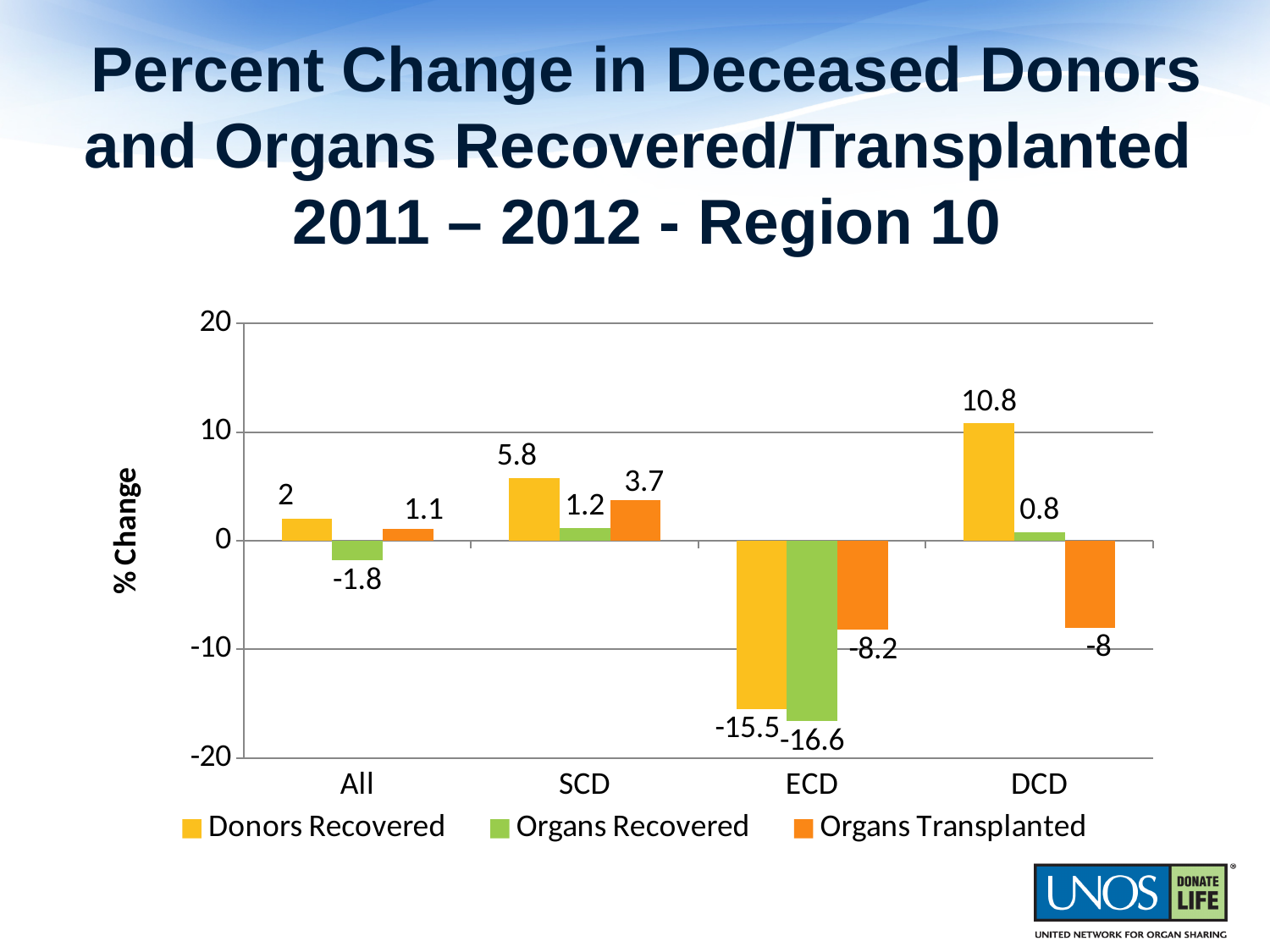
What is the value for Organs Recovered in the All category? -1.8 What is the value for Organs Transplanted in the SCD category? 3.7 How many series does the legend list? 3 What is the value for Organs Recovered in the ECD category? -16.6 What is the label of the y axis? % Change Which is larger in the ECD category: Donors Recovered or Organs Transplanted? Organs Transplanted What kind of chart is shown on the slide? Bar chart What is the difference between the Donors Recovered values for DCD and SCD? 5 Which category has the lowest value for Organs Transplanted? ECD Which category has the highest value for Donors Recovered? DCD What is the value for Donors Recovered in the DCD category? 10.8 How many categories are shown on the x axis? 4